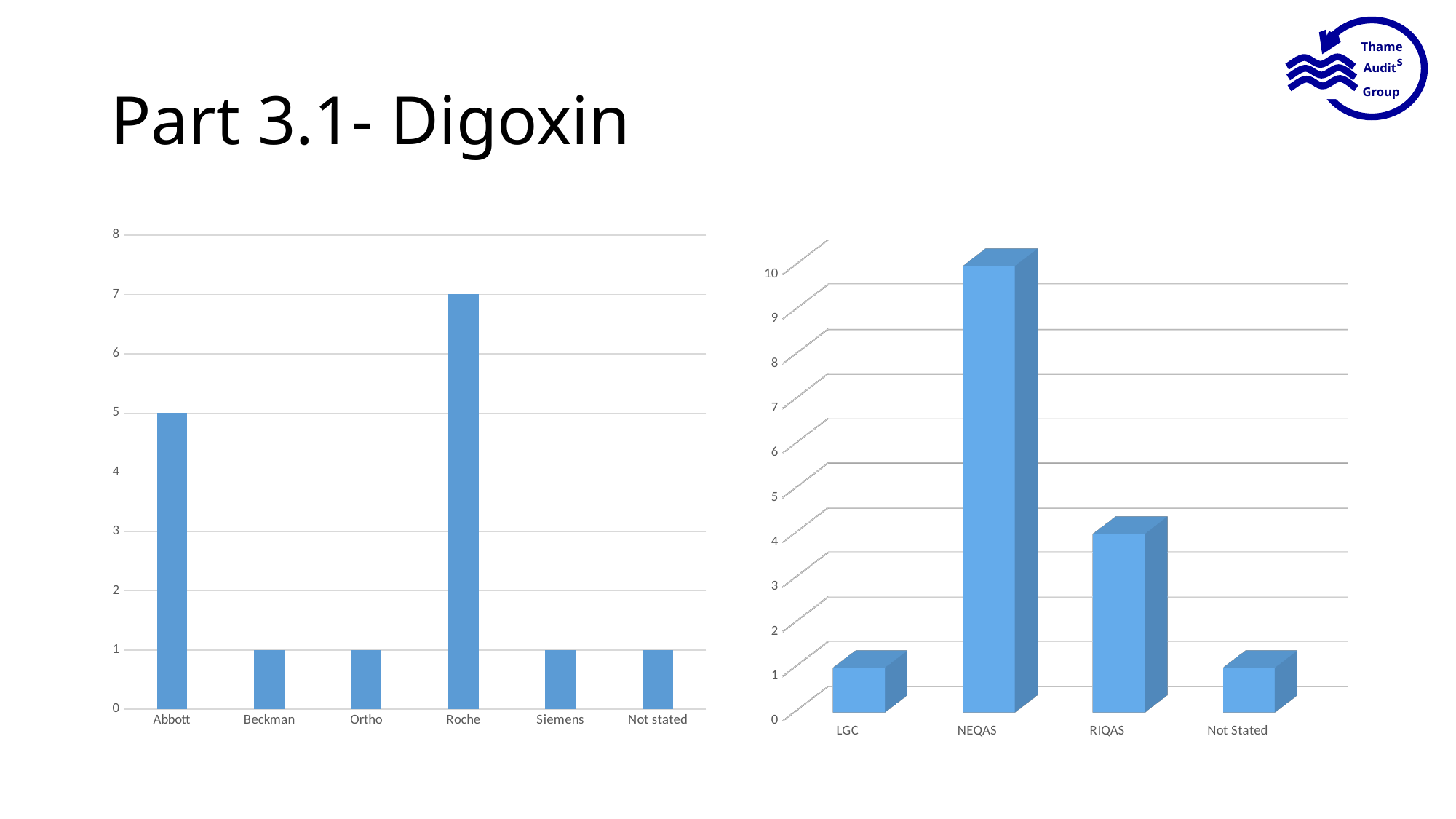
On the left chart, which category has the highest value? Roche On the left chart, how many categories are shown on the x axis? 6 On the left chart, what is the value for Abbott? 5 On the right chart, is the value for RIQAS greater or less than 6? less On the right chart, is the value for NEQAS greater or less than 8? greater What kind of chart is the chart on the right of the slide? Bar chart On the left chart, what is the value for Roche? 7 On the right chart, how many categories are shown on the x axis? 4 On the left chart, is the value for Roche greater or less than 6? greater On the left chart, which is larger, the value for Abbott or the value for Beckman? Abbott On the right chart, which category has the highest value? NEQAS On the left chart, what is the difference between the values for Roche and Abbott? 2